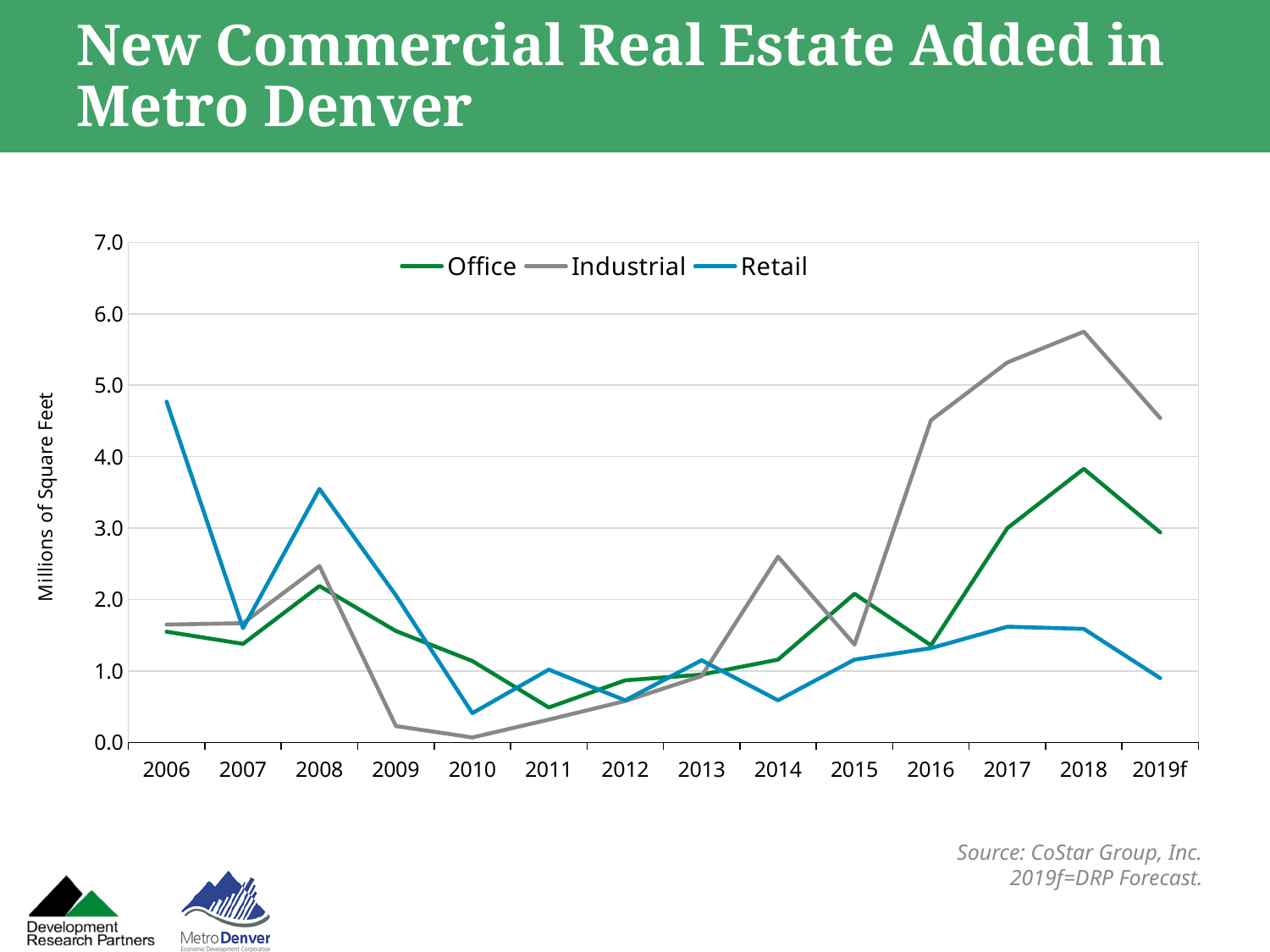
In which year does the Industrial series reach its lowest value? 2010 Is the Industrial value for 2018 greater or less than 5.0? greater What kind of chart is shown on the slide? Line chart In 2018, which series has the higher value, Industrial or Office? Industrial How many series does the legend list? 3 In which year does the Industrial series reach its highest value? 2018 Is the Industrial value for 2010 greater or less than 1.0? less Is the Office value for 2018 greater or less than 3.0? greater In which year does the Retail series reach its highest value? 2006 How many years are shown along the x axis? 14 What is the label on the y axis? Millions of Square Feet